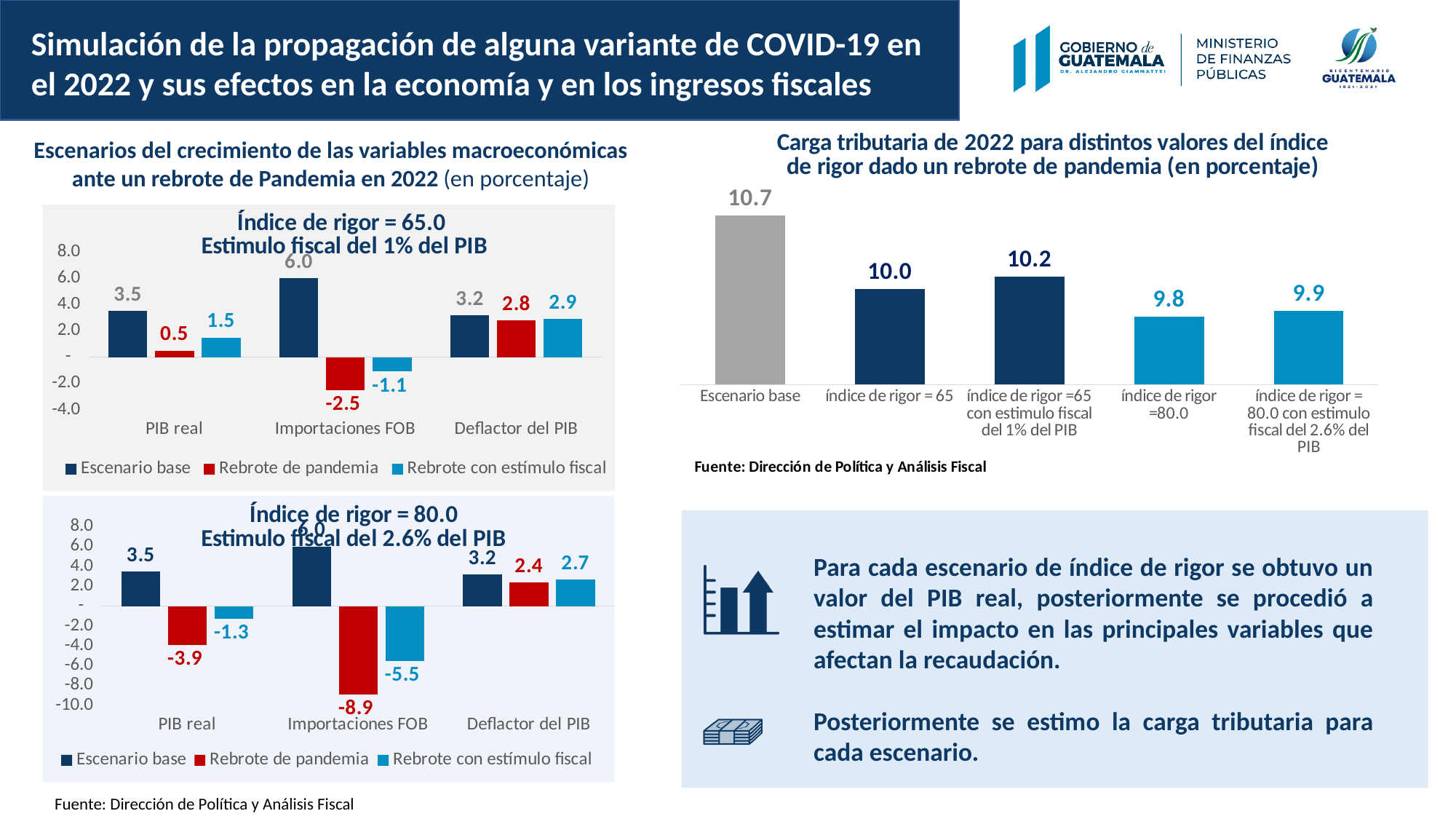
In the 'Índice de rigor = 80.0' chart, which series is shown in red? Rebrote de pandemia In the 'Índice de rigor = 65.0' chart, which is larger for 'Deflactor del PIB': 'Escenario base' or 'Rebrote de pandemia'? Escenario base In the 'Índice de rigor = 65.0' chart, what is the 'Rebrote con estímulo fiscal' value for 'PIB real'? 1.5 In the 'Carga tributaria de 2022' chart, which category has the lowest value? índice de rigor =80.0 How many bars are in the 'Carga tributaria de 2022' chart? 5 In the 'Carga tributaria de 2022' chart, what is the difference between 'Escenario base' and 'índice de rigor = 65'? 0.7 What kind of chart is the 'Índice de rigor = 80.0' chart? Bar chart In the 'Índice de rigor = 80.0' chart, what is the difference between the 'Escenario base' and 'Rebrote con estímulo fiscal' values for 'PIB real'? 4.8 In the 'Índice de rigor = 80.0' chart, what is the 'Rebrote de pandemia' value for 'Importaciones FOB'? -8.9 In the 'Índice de rigor = 65.0' chart, what is the 'Rebrote de pandemia' value for 'Importaciones FOB'? -2.5 How many series does the legend of the 'Índice de rigor = 80.0' chart list? 3 In the 'Carga tributaria de 2022' chart, what is the value for 'Escenario base'? 10.7